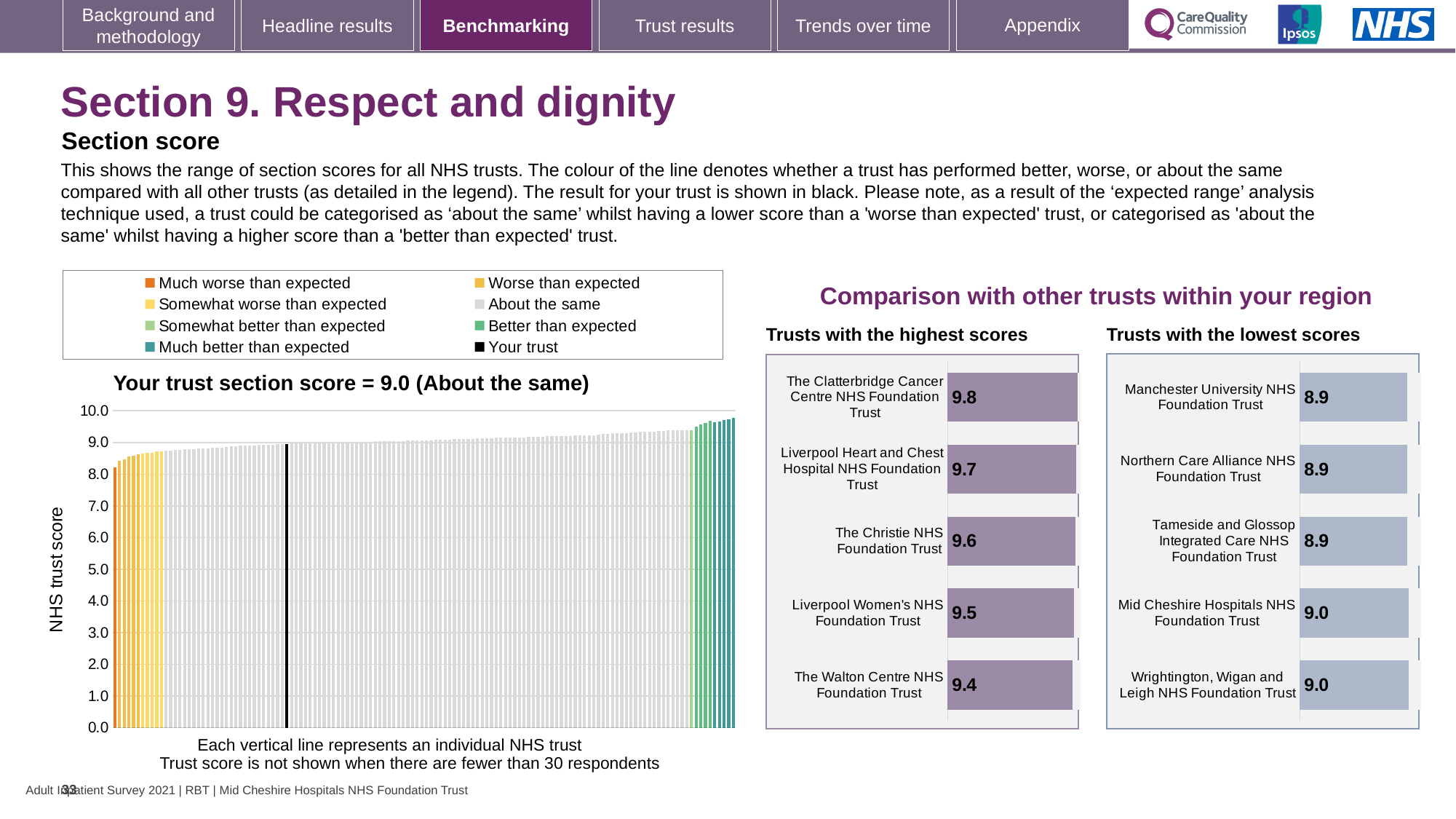
How many entries does the legend above the left chart list? 8 On the left chart, is the value for your trust (the black line) greater or less than 5.0? greater On the left chart, what is the label of the vertical axis? NHS trust score In the 'Trusts with the highest scores' chart, what is the score for The Christie NHS Foundation Trust? 9.6 In the 'Trusts with the highest scores' chart, which trust has the lowest score? The Walton Centre NHS Foundation Trust In the 'Trusts with the lowest scores' chart, which has the larger score: Mid Cheshire Hospitals NHS Foundation Trust or Manchester University NHS Foundation Trust? Mid Cheshire Hospitals NHS Foundation Trust On the left chart, what is your trust's section score as stated in the chart title? 9.0 In the 'Trusts with the highest scores' chart, which trust has the highest score? The Clatterbridge Cancer Centre NHS Foundation Trust What kind of chart is the 'Your trust section score' chart on the left of the slide? bar chart In the 'Trusts with the highest scores' chart, what is the difference between the scores of The Clatterbridge Cancer Centre NHS Foundation Trust and The Walton Centre NHS Foundation Trust? 0.4 How many trusts are shown in the 'Trusts with the lowest scores' chart? 5 On the left chart, do the bar heights rise or fall from left to right? rise